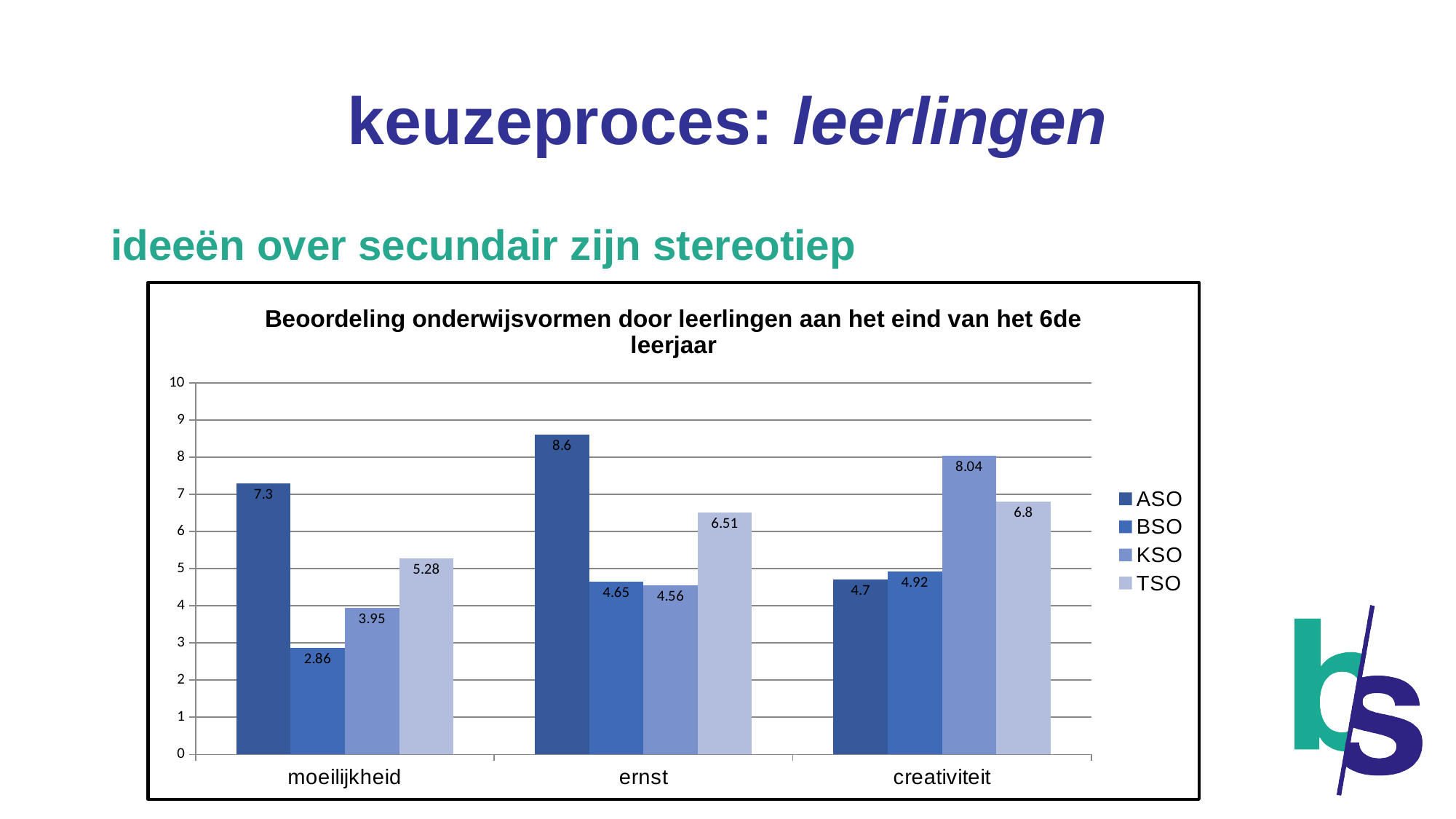
Which series has the highest value in the ernst category? ASO How many series does the legend list? 4 What is the difference between the ASO and BSO values in the ernst category? 3.95 What is the value for KSO in the creativiteit category? 8.04 How many categories are shown on the x axis? 3 Which series is shown in the lightest colour in the legend? TSO Which is larger in the creativiteit category: the value for BSO or the value for TSO? TSO What is the value for TSO in the ernst category? 6.51 What is the value for ASO in the moeilijkheid category? 7.3 Which series has the lowest value in the moeilijkheid category? BSO What kind of chart is shown on the slide? bar chart What is the title of the chart? Beoordeling onderwijsvormen door leerlingen aan het eind van het 6de leerjaar